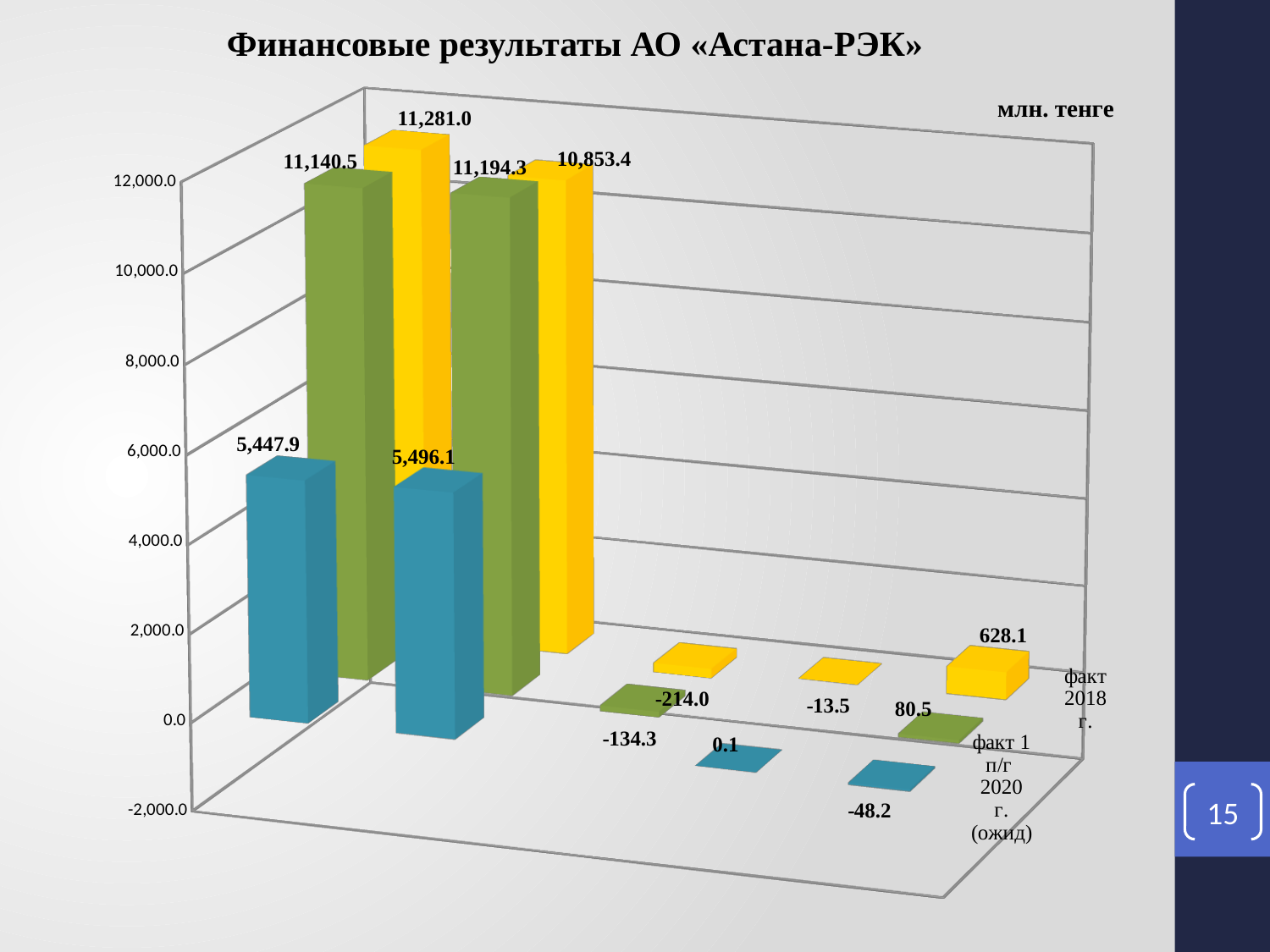
What is the title of the chart? Финансовые результаты АО «Астана-РЭК» Is the highest value in the "факт 1 п/г 2020 г. (ожид)" series greater or less than 6,000.0? less What is the difference between the two largest values in the "факт 2018 г." series, 11,281.0 and 10,853.4? 427.6 What is the value of the rightmost bar in the "факт 2018 г." series? 628.1 How many bars are plotted for the "факт 2018 г." series? 5 What is the highest value in the "факт 1 п/г 2020 г. (ожид)" series? 5,496.1 What is the lowest value in the "факт 1 п/г 2020 г. (ожид)" series? -48.2 In what units are the values on the chart expressed? млн. тенге What kind of chart is shown on the slide? bar chart What is the highest value in the "факт 2018 г." series? 11,281.0 What is the lowest value in the "факт 2018 г." series? -214.0 Which is larger: the leftmost bar of the "факт 2018 г." series or the leftmost bar of the "факт 1 п/г 2020 г. (ожид)" series? факт 2018 г.